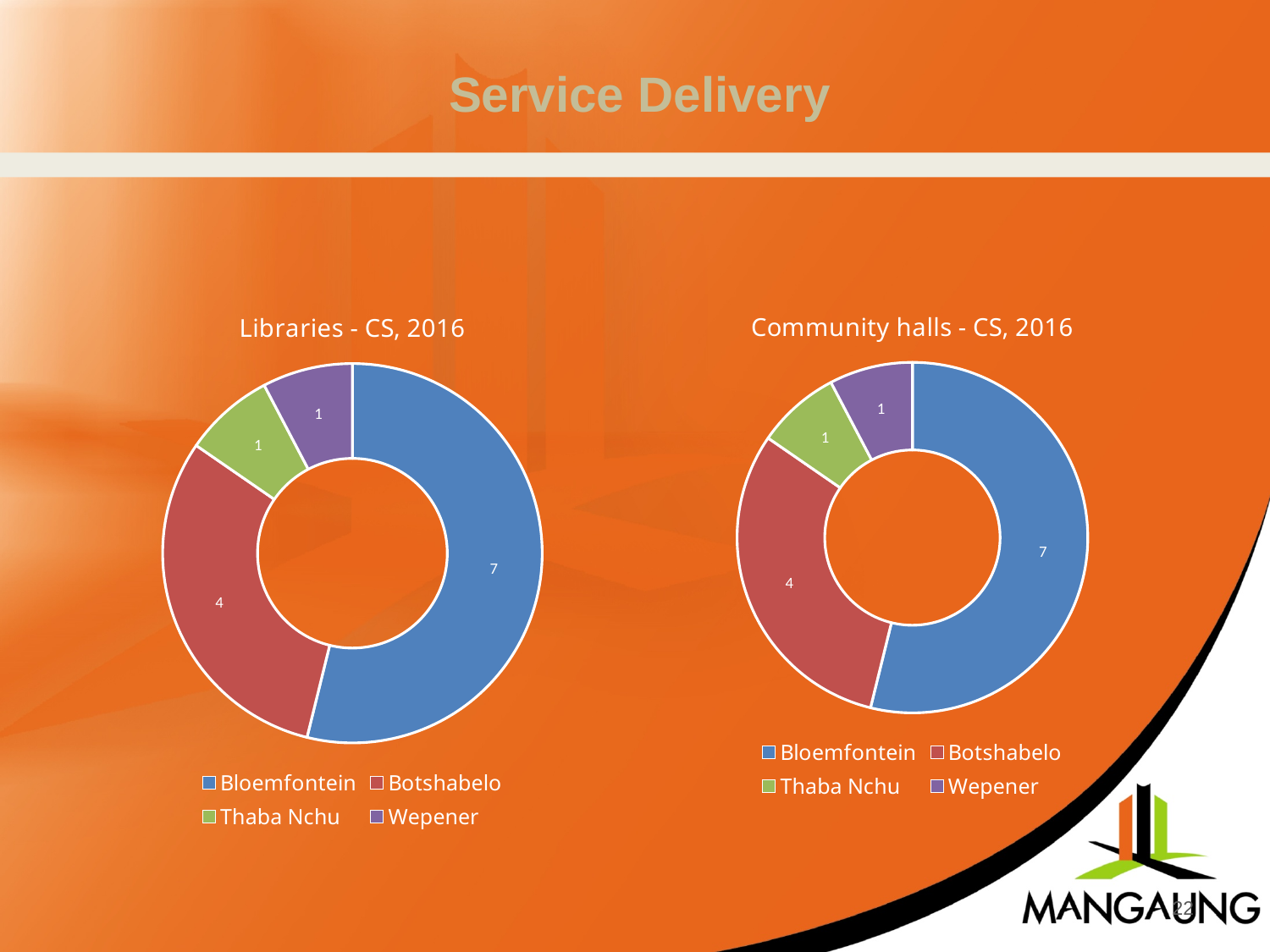
In the 'Community halls - CS, 2016' chart, what is the difference between the values for Botshabelo and Thaba Nchu? 3 In the 'Community halls - CS, 2016' chart, what is the value for Botshabelo? 4 In the 'Community halls - CS, 2016' chart, what is the value for Wepener? 1 In the 'Libraries - CS, 2016' chart, which is larger, the value for Botshabelo or the value for Wepener? Botshabelo What kind of chart is the 'Community halls - CS, 2016' chart? doughnut chart In the 'Libraries - CS, 2016' chart, what is the difference between the values for Bloemfontein and Botshabelo? 3 In the 'Libraries - CS, 2016' chart, what is the value for Bloemfontein? 7 In the 'Libraries - CS, 2016' chart, what is the value for Thaba Nchu? 1 In the 'Community halls - CS, 2016' chart, which category has the largest value? Bloemfontein In the 'Libraries - CS, 2016' chart, which category has the largest value? Bloemfontein What is the total of all values in the 'Libraries - CS, 2016' chart? 13 How many categories are shown in the 'Community halls - CS, 2016' chart? 4